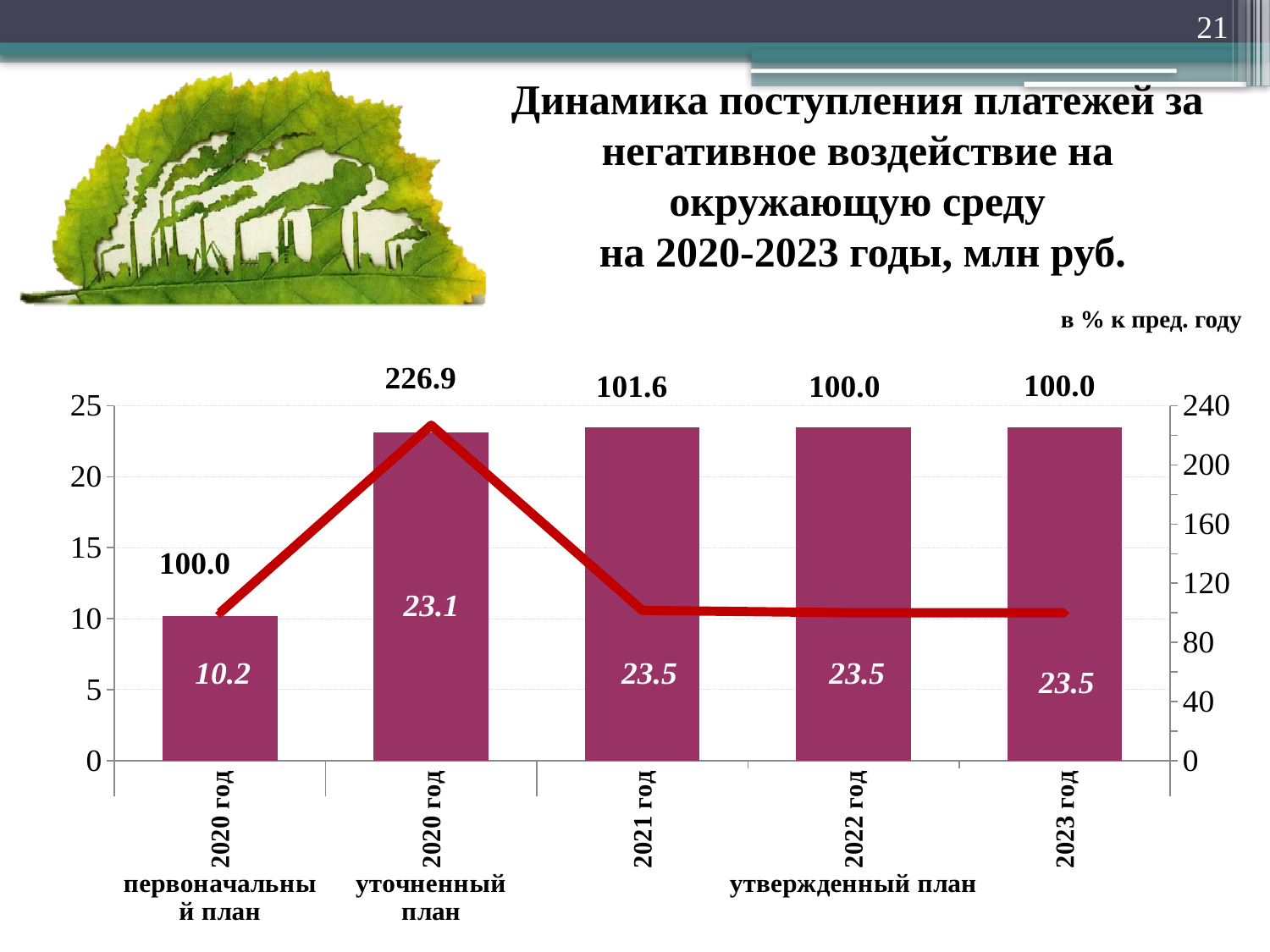
What is the difference between the bar values for 2020 год (уточненный план) and 2020 год (первоначальный план)? 12.9 What is the line value (в % к пред. году) for 2020 год (уточненный план)? 226.9 What is the line value (в % к пред. году) for 2021 год? 101.6 Which category has the lowest bar value? 2020 год (первоначальный план) What is the title of the chart? Динамика поступления платежей за негативное воздействие на окружающую среду на 2020-2023 годы, млн руб. Which is larger: the bar value for 2021 год or for 2020 год (уточненный план)? 2021 год Which category has the highest line value (в % к пред. году)? 2020 год (уточненный план) How many bars are plotted on the chart? 5 What is the bar value for 2020 год (первоначальный план)? 10.2 What is the bar value for 2023 год? 23.5 What is the bar value for 2020 год (уточненный план)? 23.1 What kind of chart is shown on the slide? Combined bar and line chart